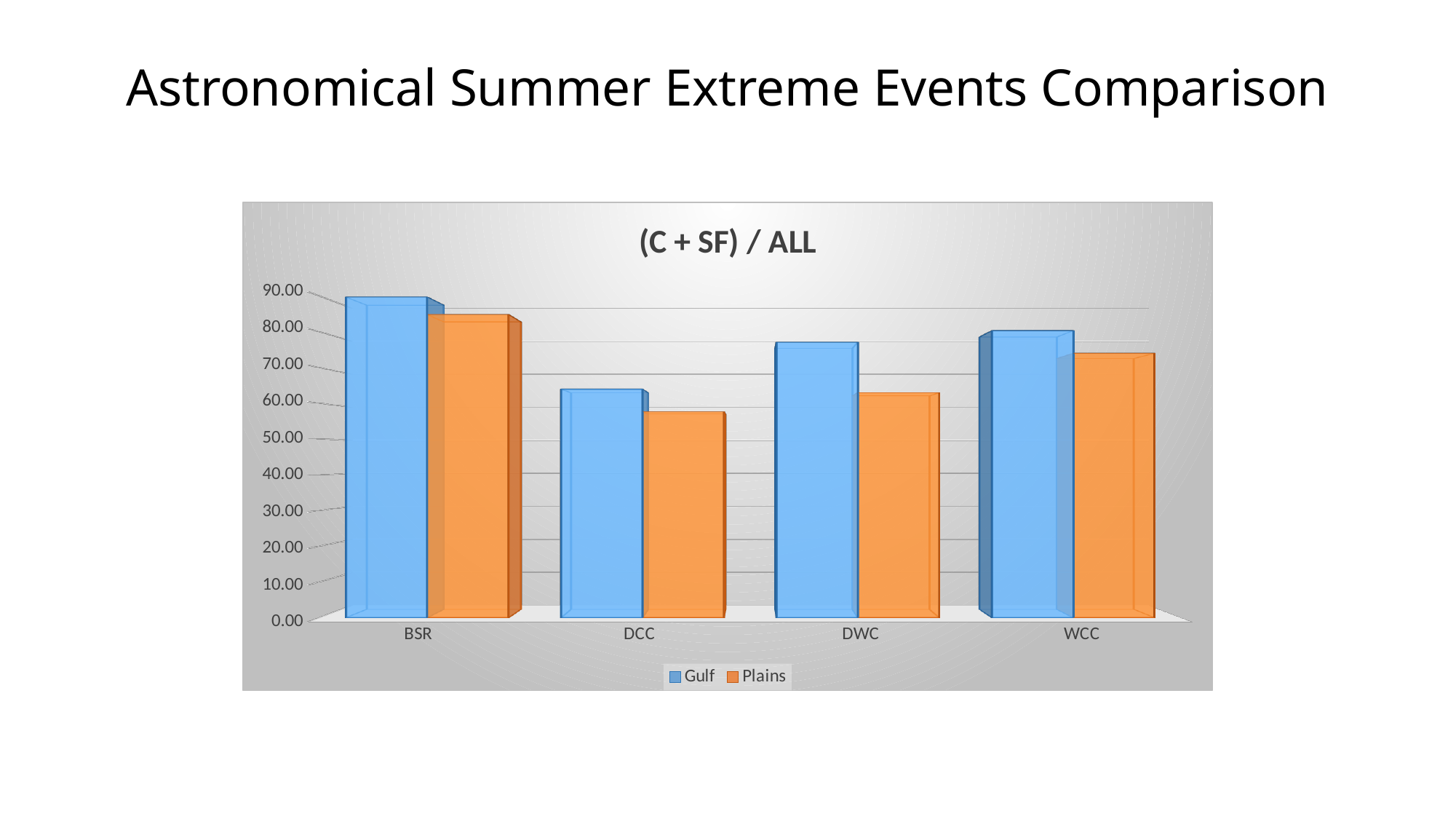
Which category has the lowest Plains value? DCC Is the Plains value for DWC greater or less than 70.00? less Is the Plains value for DCC greater or less than 60.00? less Is the Gulf value for BSR greater or less than 80.00? greater How many categories are shown on the x axis of the chart? 4 For DWC, which series has the larger value, Gulf or Plains? Gulf How many series does the chart legend list? 2 Which category has the lowest Gulf value? DCC Which category has the highest Gulf value? BSR Which category has the highest Plains value? BSR What kind of chart is shown on the slide? bar chart What is the title shown inside the chart area? (C + SF) / ALL